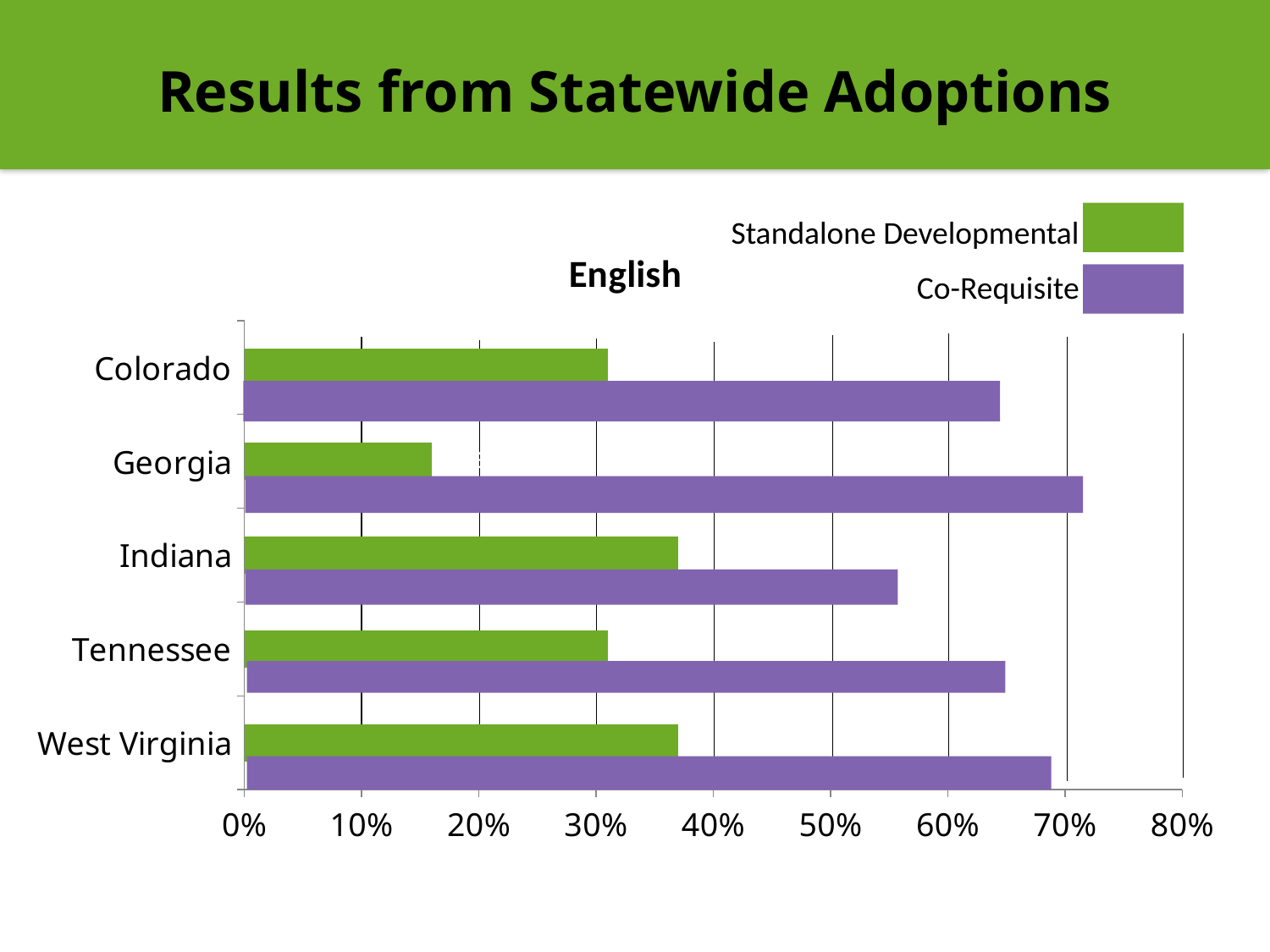
What kind of chart is shown on the slide? bar chart Which state has the lowest Co-Requisite value? Indiana Is the Standalone Developmental value for Georgia greater or less than 20%? less Is the Standalone Developmental value for West Virginia greater or less than 40%? less Is the Co-Requisite value for Indiana greater or less than 50%? greater Which state has the highest Co-Requisite value? Georgia What subject does the chart's title say the results are for? English For Colorado, which is larger: the Standalone Developmental value or the Co-Requisite value? Co-Requisite How many states are shown on the chart? 5 Which state has the lowest Standalone Developmental value? Georgia How many series does the legend list? 2